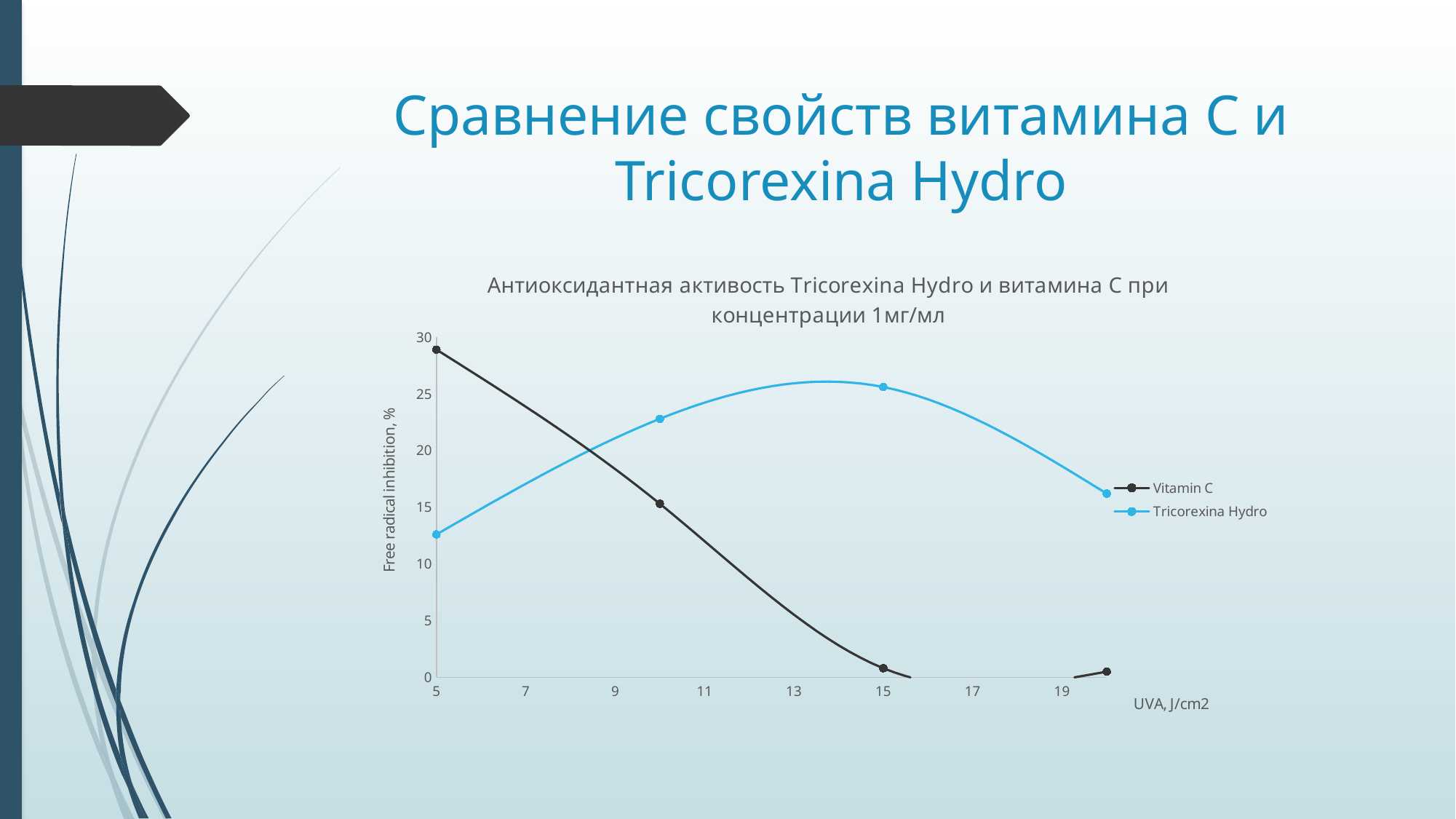
Is the value for Tricorexina Hydro at UVA 20 J/cm2 greater or less than 20? less Is the value for Tricorexina Hydro at UVA 5 J/cm2 greater or less than 15? less What kind of chart is shown on the slide? line chart Is the value for Vitamin C at UVA 15 J/cm2 greater or less than 5? less How many series does the legend list? 2 At UVA 15 J/cm2, which series has the higher free radical inhibition, Vitamin C or Tricorexina Hydro? Tricorexina Hydro Does the Vitamin C series rise or fall as UVA increases from 5 to 15 J/cm2? fall At UVA 5 J/cm2, which series has the higher free radical inhibition, Vitamin C or Tricorexina Hydro? Vitamin C How many data points are plotted for the Tricorexina Hydro series? 4 At which UVA value does the Tricorexina Hydro series reach its highest point? 15